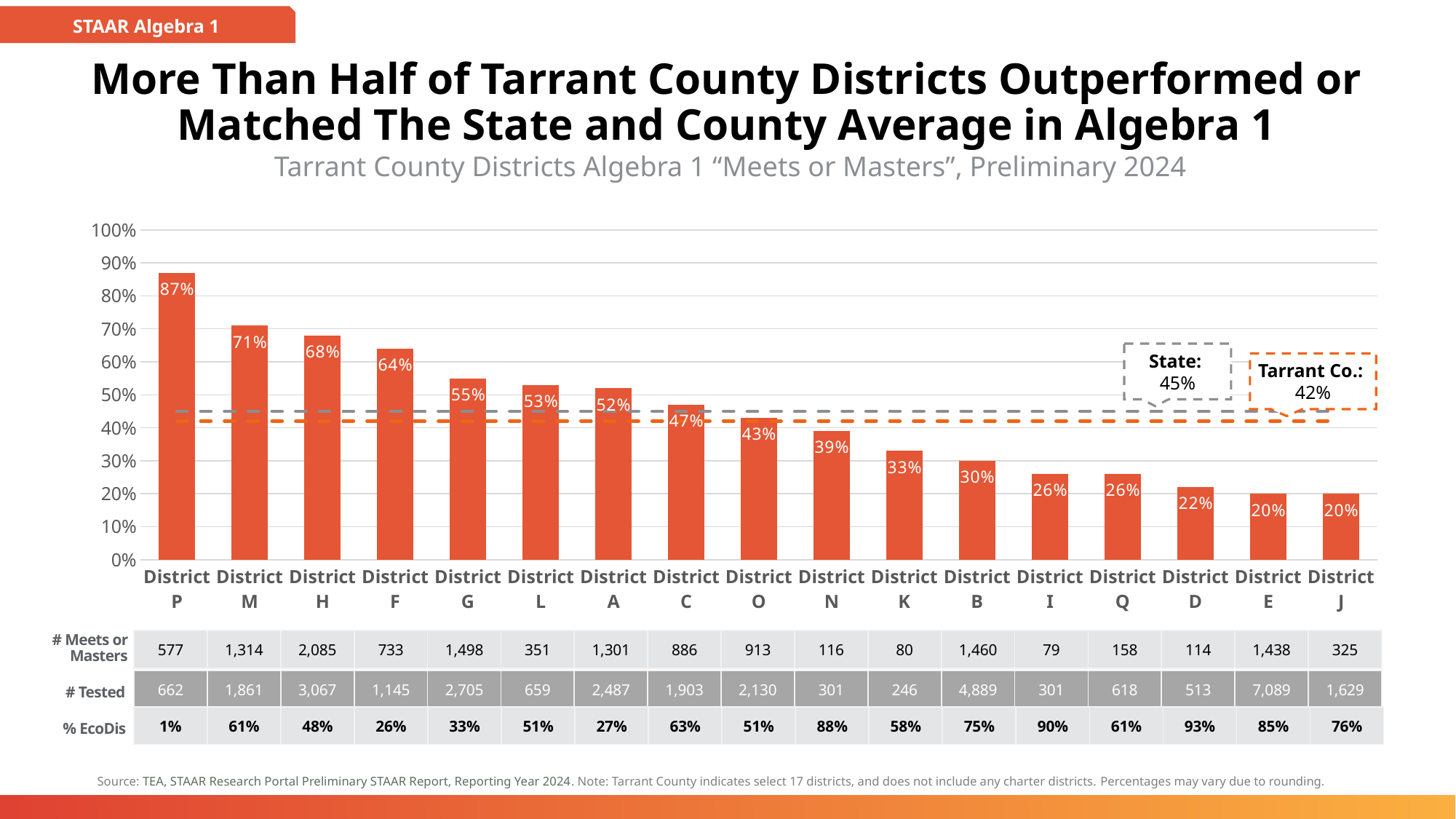
What is the State average shown by the dashed line? 45% Which district has the highest "Meets or Masters" percentage? District P What is the "Meets or Masters" percentage for District C? 47% Do the bar values rise or fall from left to right along the x axis? Fall Which district has the lowest "Meets or Masters" percentage among those with a unique lowest value, or what is the lowest value shown? 20% What is the "Meets or Masters" percentage for District P? 87% Is the value for District O greater or less than 50%? less What is the Tarrant Co. average shown by the dashed line? 42% What kind of chart is shown on the slide? Bar chart How many districts are shown in the chart? 17 Which has a higher "Meets or Masters" percentage, District G or District N? District G What is the difference in "Meets or Masters" percentage between District M and District H? 3%